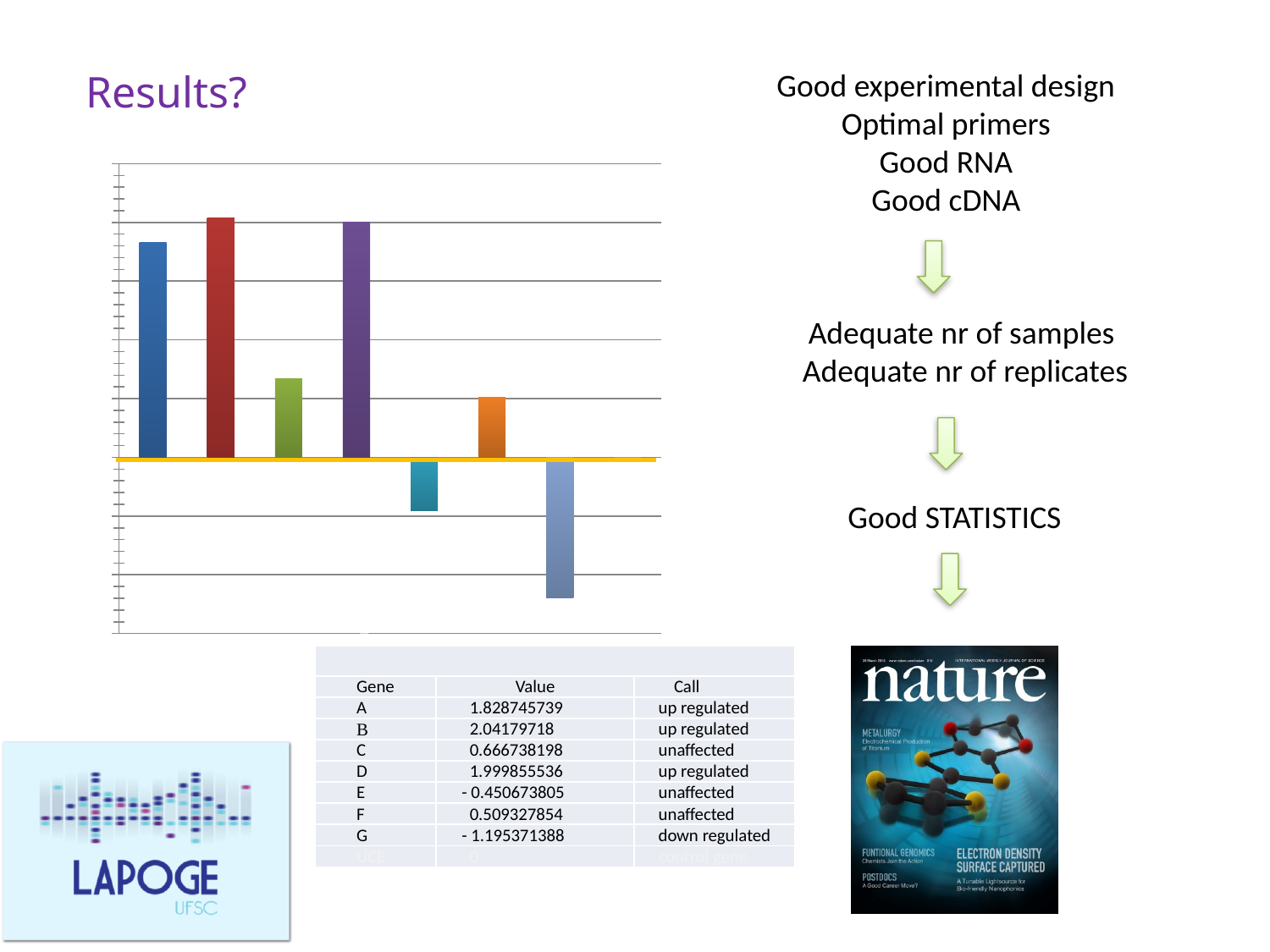
How many bars in the chart extend below the horizontal zero line? 2 What colour is the horizontal baseline drawn across the chart at zero? orange What kind of chart is shown on the left of the slide? bar chart Which bar in the chart reaches the lowest value? the seventh (grey-blue) bar Which is taller in the chart, the third (green) bar or the sixth (orange) bar? the third (green) bar Which bar in the chart is the tallest? the second (red) bar How many bars does the chart on the left of the slide contain? 7 How many bars in the chart extend above the horizontal zero line? 5 Which bar extends further below the zero line, the fifth (teal) bar or the seventh (grey-blue) bar? the seventh (grey-blue) bar Which is taller in the chart, the first (blue) bar or the third (green) bar? the first (blue) bar